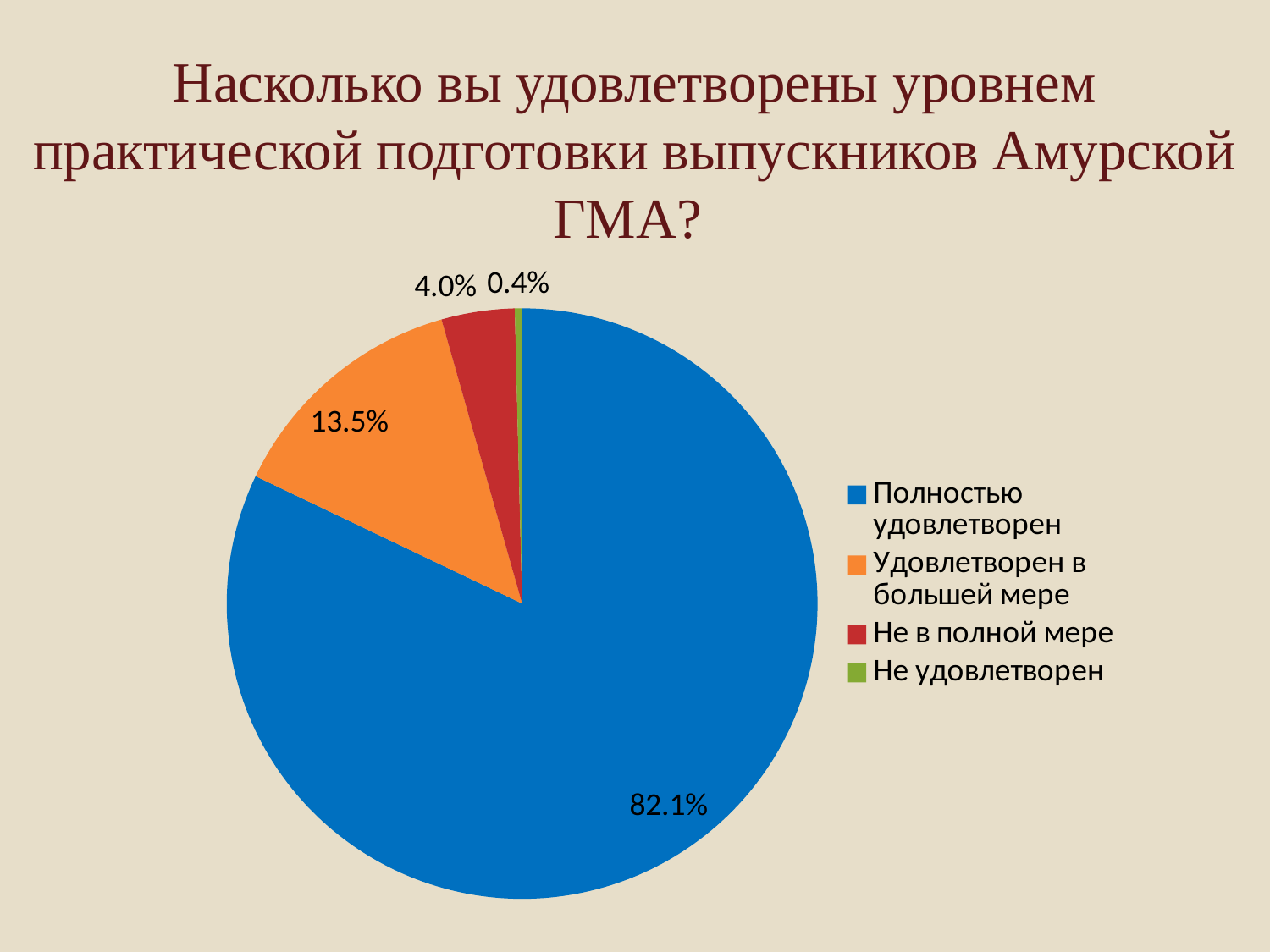
What colour is the slice for "Удовлетворен в большей мере"? orange Which category has the smallest slice of the pie? Не удовлетворен What share of the pie is labelled "Полностью удовлетворен"? 82.1% How many categories does the legend list? 4 Which category has the largest slice of the pie? Полностью удовлетворен What share of the pie is labelled "Не в полной мере"? 4.0% What kind of chart is shown on the slide? pie chart What is the difference between the shares for "Удовлетворен в большей мере" and "Не в полной мере"? 9.5% What is the difference between the shares for "Полностью удовлетворен" and "Удовлетворен в большей мере"? 68.6% Which is larger: the share for "Не в полной мере" or the share for "Не удовлетворен"? Не в полной мере What share of the pie is labelled "Не удовлетворен"? 0.4% What share of the pie is labelled "Удовлетворен в большей мере"? 13.5%